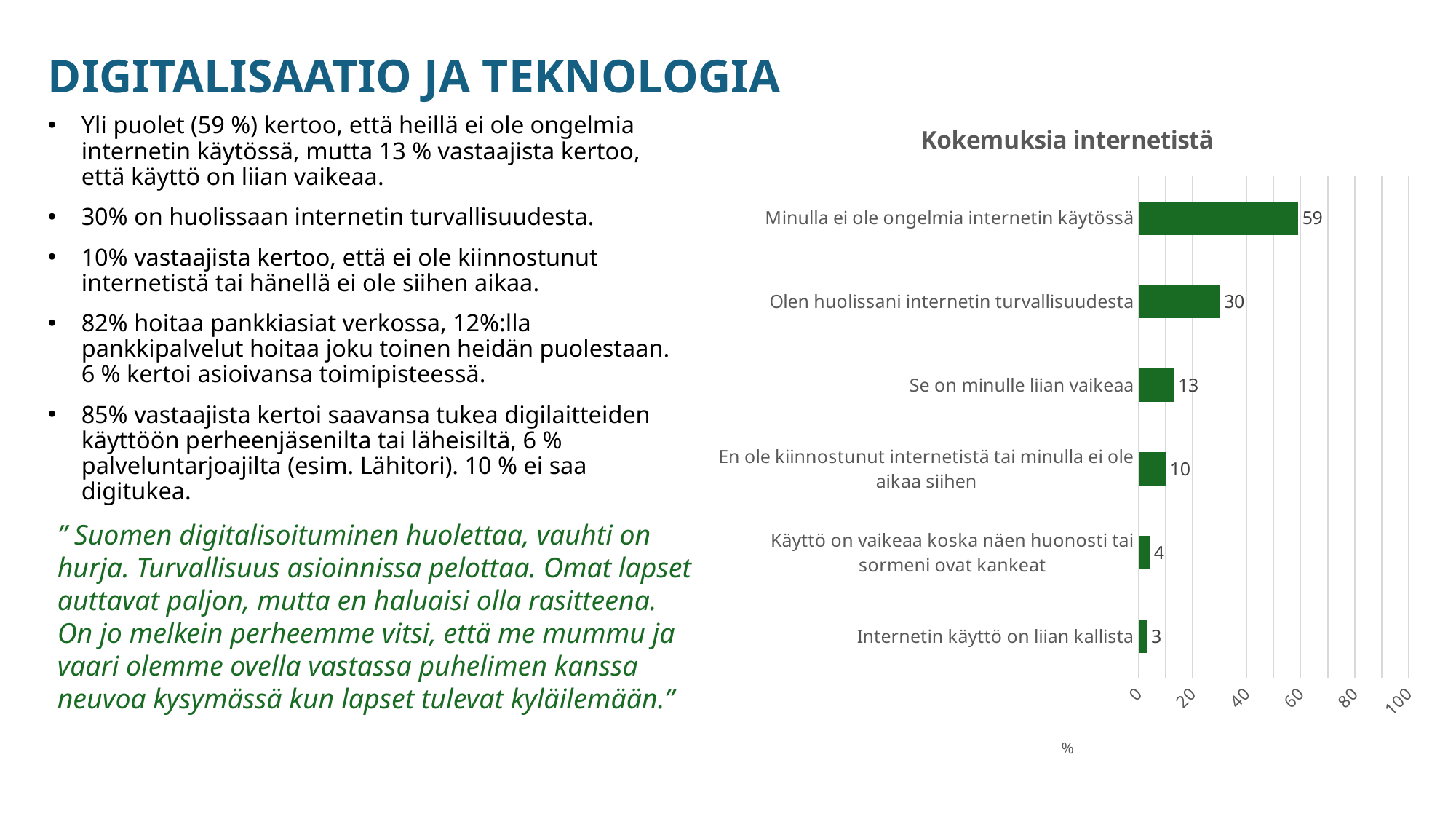
What is the value for "Internetin käyttö on liian kallista"? 3 What is the title of the chart? Kokemuksia internetistä Which category has the lowest value? Internetin käyttö on liian kallista How many categories are shown in the chart? 6 What is the value for "Olen huolissani internetin turvallisuudesta"? 30 What is the value for "Se on minulle liian vaikeaa"? 13 Which is larger: the value for "Se on minulle liian vaikeaa" or the value for "En ole kiinnostunut internetistä tai minulla ei ole aikaa siihen"? Se on minulle liian vaikeaa What is the difference between the values for "Minulla ei ole ongelmia internetin käytössä" and "Olen huolissani internetin turvallisuudesta"? 29 Which category has the highest value? Minulla ei ole ongelmia internetin käytössä What kind of chart is shown on the slide? bar chart What is the value for "Minulla ei ole ongelmia internetin käytössä"? 59 Is the value for "Olen huolissani internetin turvallisuudesta" greater or less than 40? less